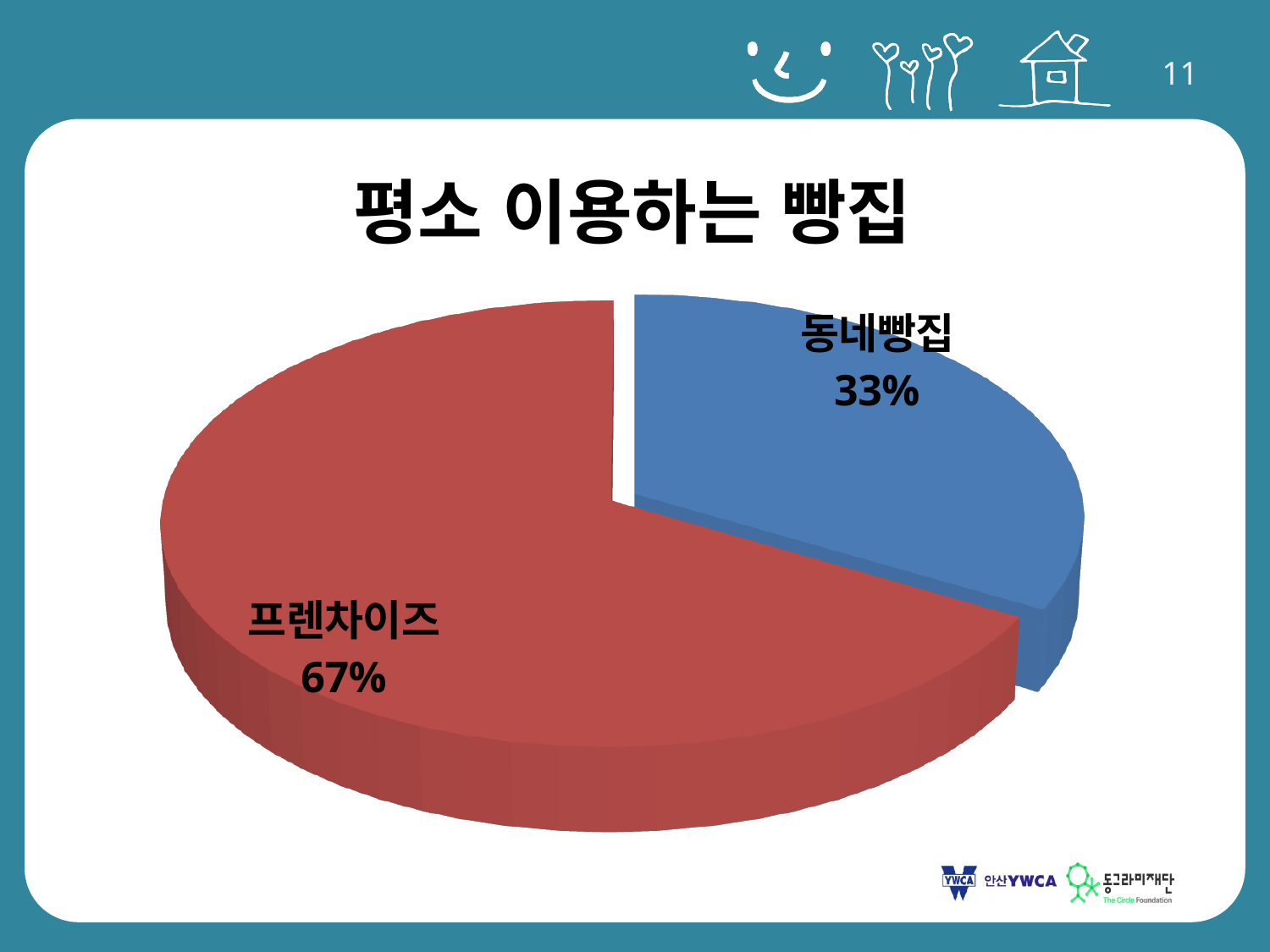
What is the title of the chart? 평소 이용하는 빵집 What share of the pie does 동네빵집 have? 33% How many slices does the pie chart have? 2 What share of the pie does 프렌차이즈 have? 67% What colour is the 동네빵집 slice? blue Which category has the smallest slice of the pie? 동네빵집 What kind of chart is shown on the slide? pie chart Which is larger, the share for 동네빵집 or the share for 프렌차이즈? 프렌차이즈 What is the difference in percentage points between 프렌차이즈 and 동네빵집? 34 Which category has the largest slice of the pie? 프렌차이즈